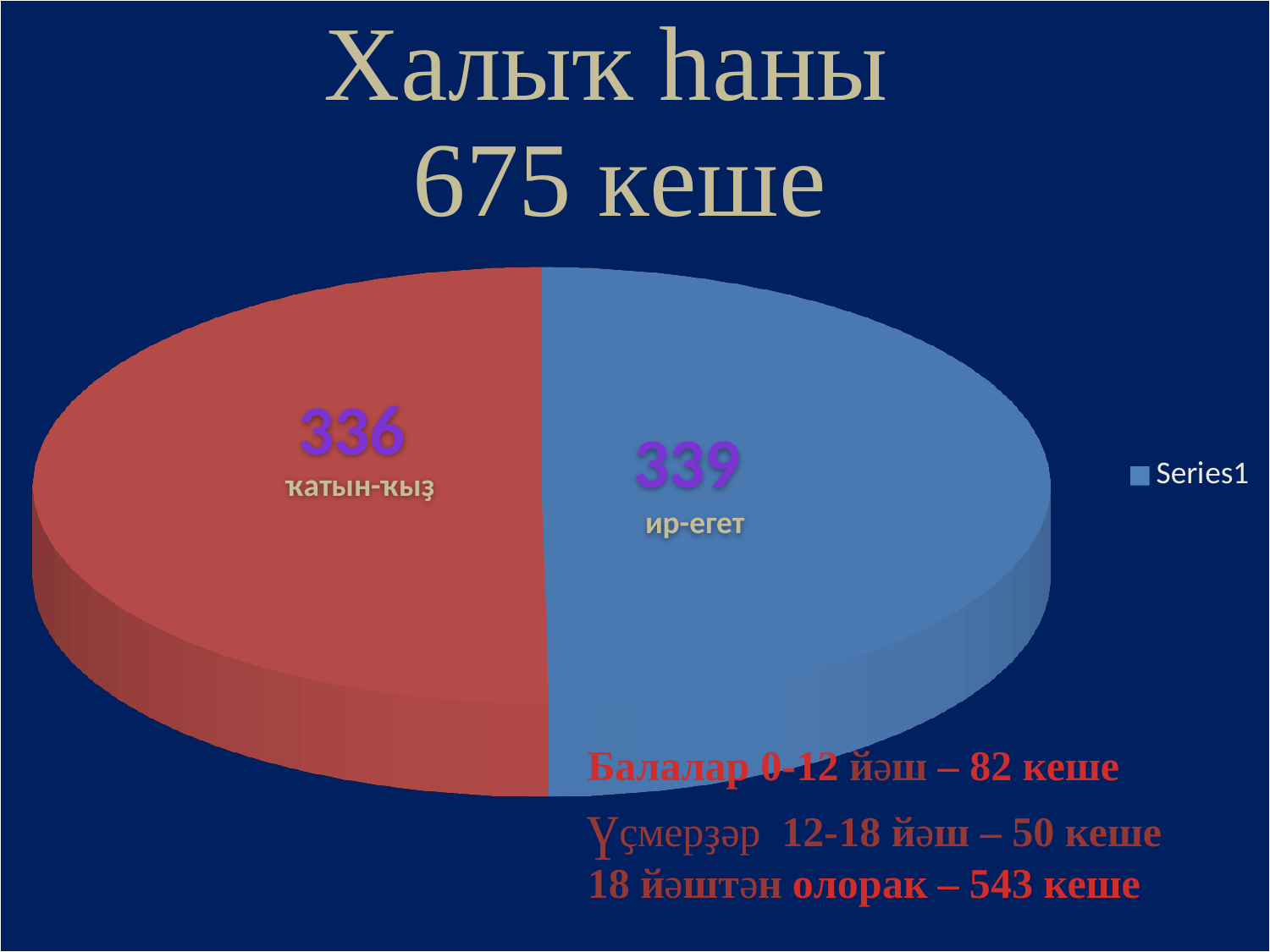
What colour is the ҡатын-ҡыҙ slice? red How many slices does the pie chart have? 2 What kind of chart is shown on the slide? pie chart What is the value shown for the ир-егет slice? 339 Which slice has the larger value, ҡатын-ҡыҙ or ир-егет? ир-егет What is the total of the two slices in the pie chart? 675 What is the legend entry shown next to the pie chart? Series1 What share of the pie does the ир-егет slice represent? 50.2% Which slice has the smallest value? ҡатын-ҡыҙ What is the difference between the ир-егет value and the ҡатын-ҡыҙ value? 3 What is the value shown for the ҡатын-ҡыҙ slice? 336 How many series does the legend list? 1